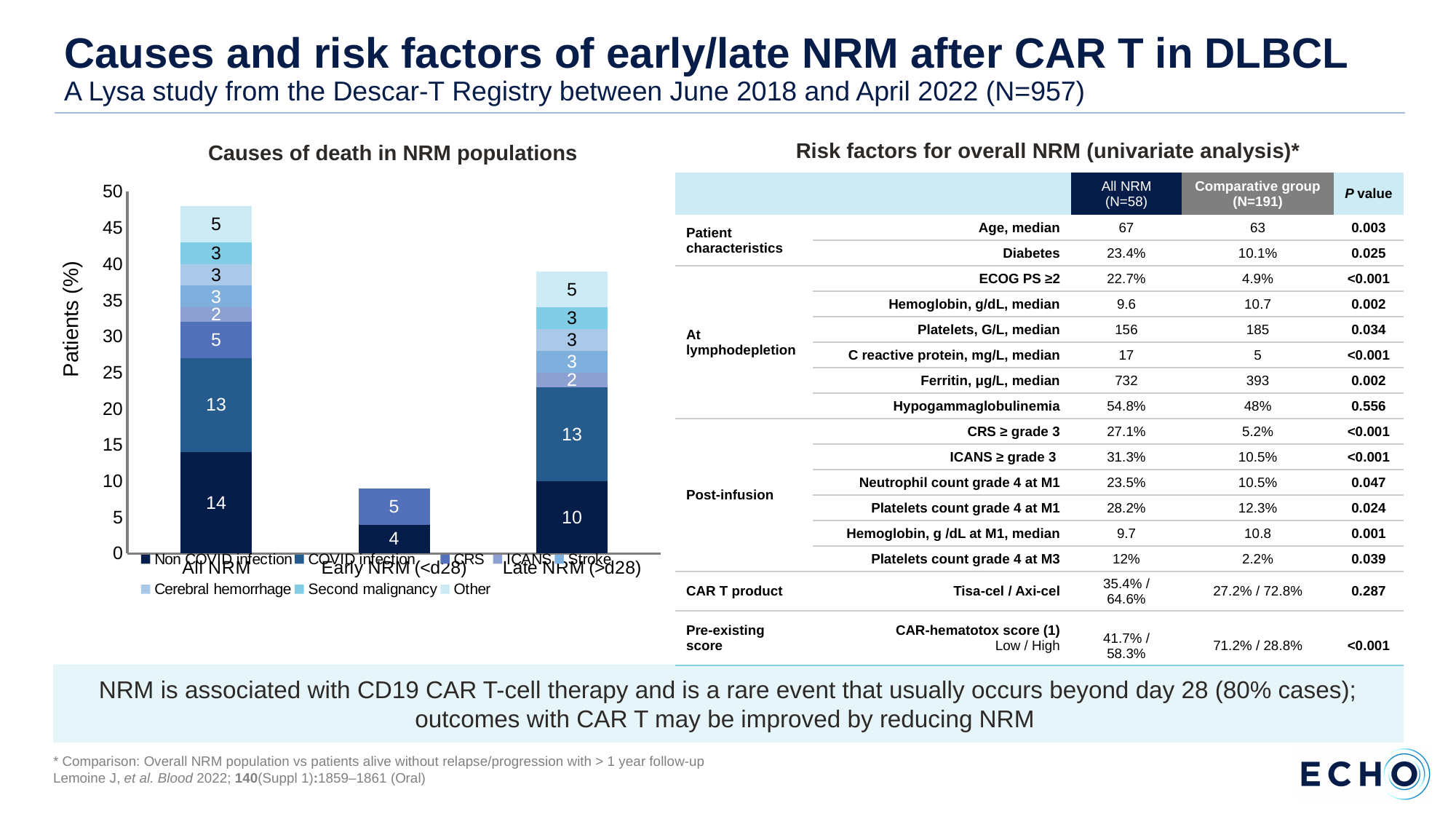
How many categories are shown on the x axis of the 'Causes of death in NRM populations' chart? 3 In the 'Causes of death in NRM populations' chart, what is the total of the Early NRM (<d28) stacked bar? 9 In the 'Causes of death in NRM populations' chart, what is the value for COVID infection in the Late NRM (>d28) bar? 13 In the 'Causes of death in NRM populations' chart, what is the value for Non COVID infection in the Early NRM (<d28) bar? 4 In the 'Causes of death in NRM populations' chart, which category has the tallest stacked bar? All NRM In the 'Causes of death in NRM populations' chart, what is the total of the All NRM stacked bar? 48 What kind of chart is 'Causes of death in NRM populations'? Stacked bar chart How many series does the legend of the 'Causes of death in NRM populations' chart list? 8 In the 'Causes of death in NRM populations' chart, what is the difference between the Non COVID infection values for All NRM and Late NRM (>d28)? 4 In the 'Causes of death in NRM populations' chart, what is the value for Other in the Late NRM (>d28) bar? 5 In the 'Causes of death in NRM populations' chart, what is the total of the Late NRM (>d28) stacked bar? 39 In the 'Causes of death in NRM populations' chart, what is the value for Non COVID infection in the All NRM bar? 14